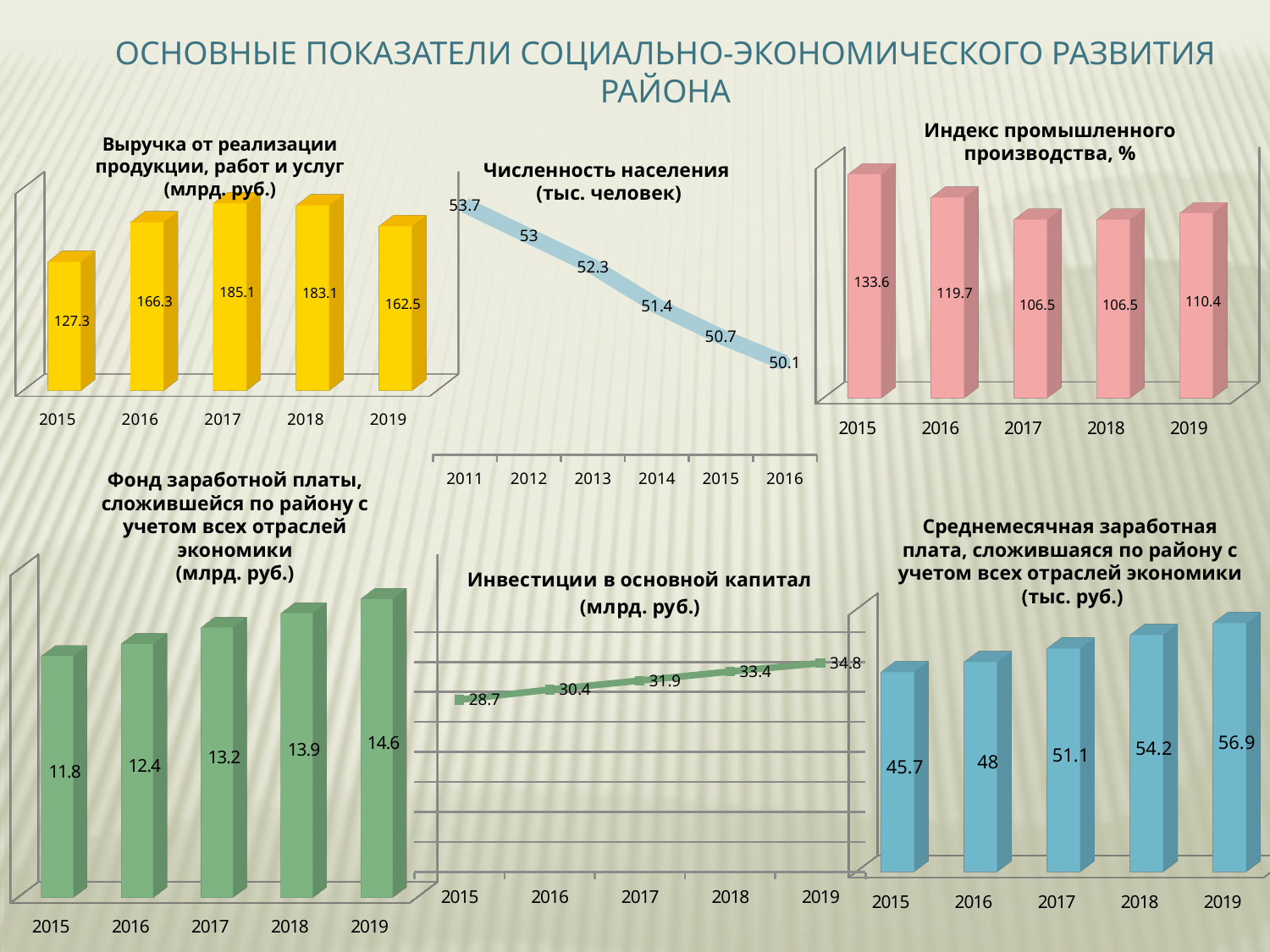
In the chart 'Среднемесячная заработная плата, сложившаяся по району с учетом всех отраслей экономики (тыс. руб.)', which is larger, the value for 2016 or the value for 2018? 2018 In the chart 'Численность населения (тыс. человек)', what is the value for 2013? 52.3 In the chart 'Инвестиции в основной капитал (млрд. руб.)', what is the value for 2016? 30.4 In the chart 'Численность населения (тыс. человек)', do the values rise or fall from 2011 to 2016? fall How many years are shown in the chart 'Фонд заработной платы, сложившейся по району с учетом всех отраслей экономики (млрд. руб.)'? 5 What kind of chart is 'Среднемесячная заработная плата, сложившаяся по району с учетом всех отраслей экономики (тыс. руб.)'? bar chart What kind of chart is 'Численность населения (тыс. человек)'? line chart In the chart 'Индекс промышленного производства, %', what is the difference between the 2015 and 2016 values? 13.9 In the chart 'Выручка от реализации продукции, работ и услуг (млрд. руб.)', what is the value for 2017? 185.1 In the chart 'Фонд заработной платы, сложившейся по району с учетом всех отраслей экономики (млрд. руб.)', what is the value for 2019? 14.6 In the chart 'Индекс промышленного производства, %', which year has the highest value? 2015 In the chart 'Выручка от реализации продукции, работ и услуг (млрд. руб.)', which year has the lowest value? 2015